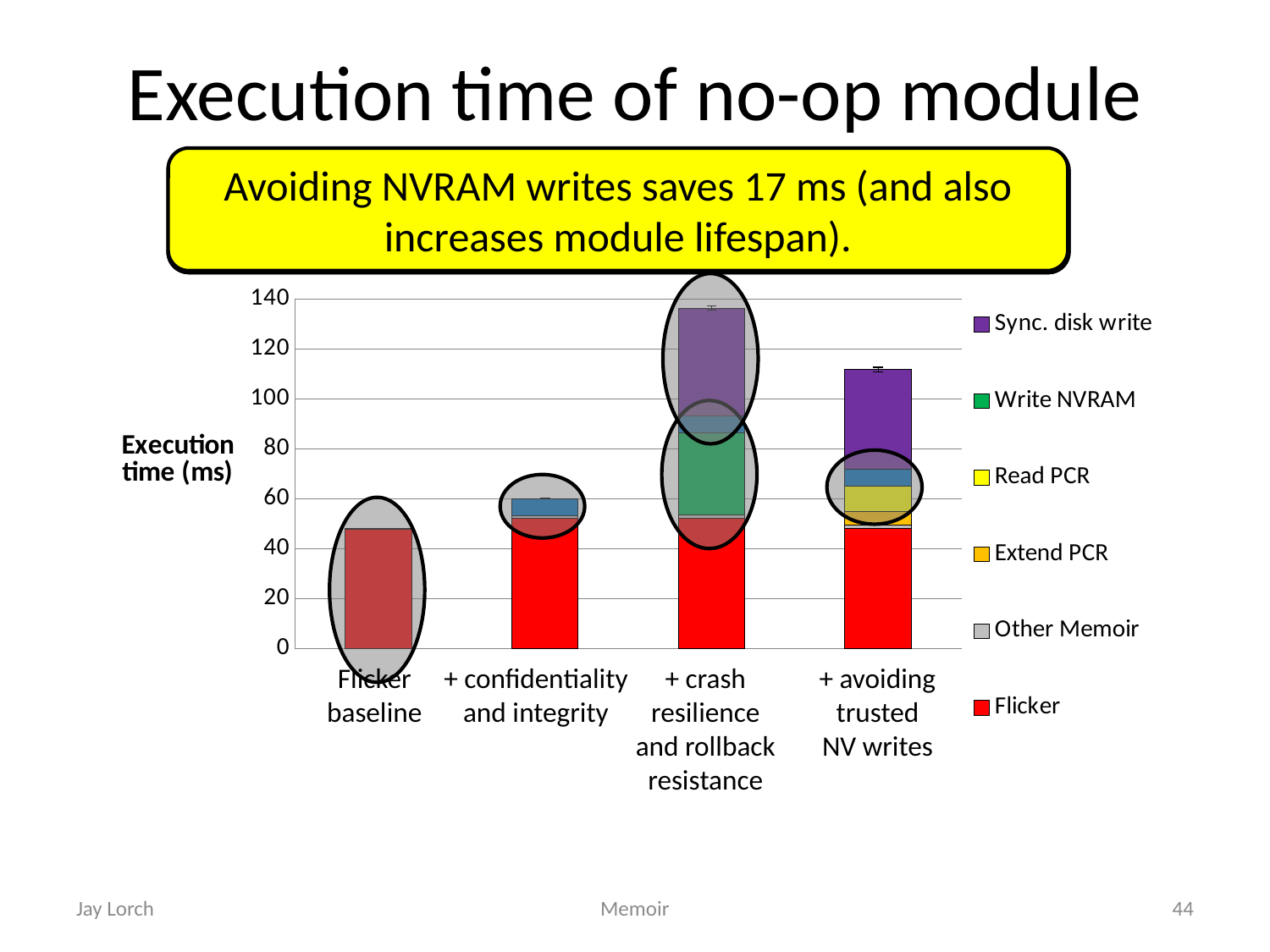
What kind of chart is shown on the slide? Stacked bar chart What is the label on the y axis of the chart? Execution time (ms) Is the total value for + avoiding trusted NV writes greater or less than 100? greater Which category has the tallest total bar? + crash resilience and rollback resistance Is the total value for Flicker baseline greater or less than 60? less Which series is listed first (at the top) in the legend? Sync. disk write Is the total value for + crash resilience and rollback resistance greater or less than 120? greater Which category has the shortest total bar? Flicker baseline Which total bar is larger: + crash resilience and rollback resistance or + avoiding trusted NV writes? + crash resilience and rollback resistance Which total bar is larger: Flicker baseline or + confidentiality and integrity? + confidentiality and integrity How many series does the legend list? 6 How many bars (categories) are plotted on the x axis? 4